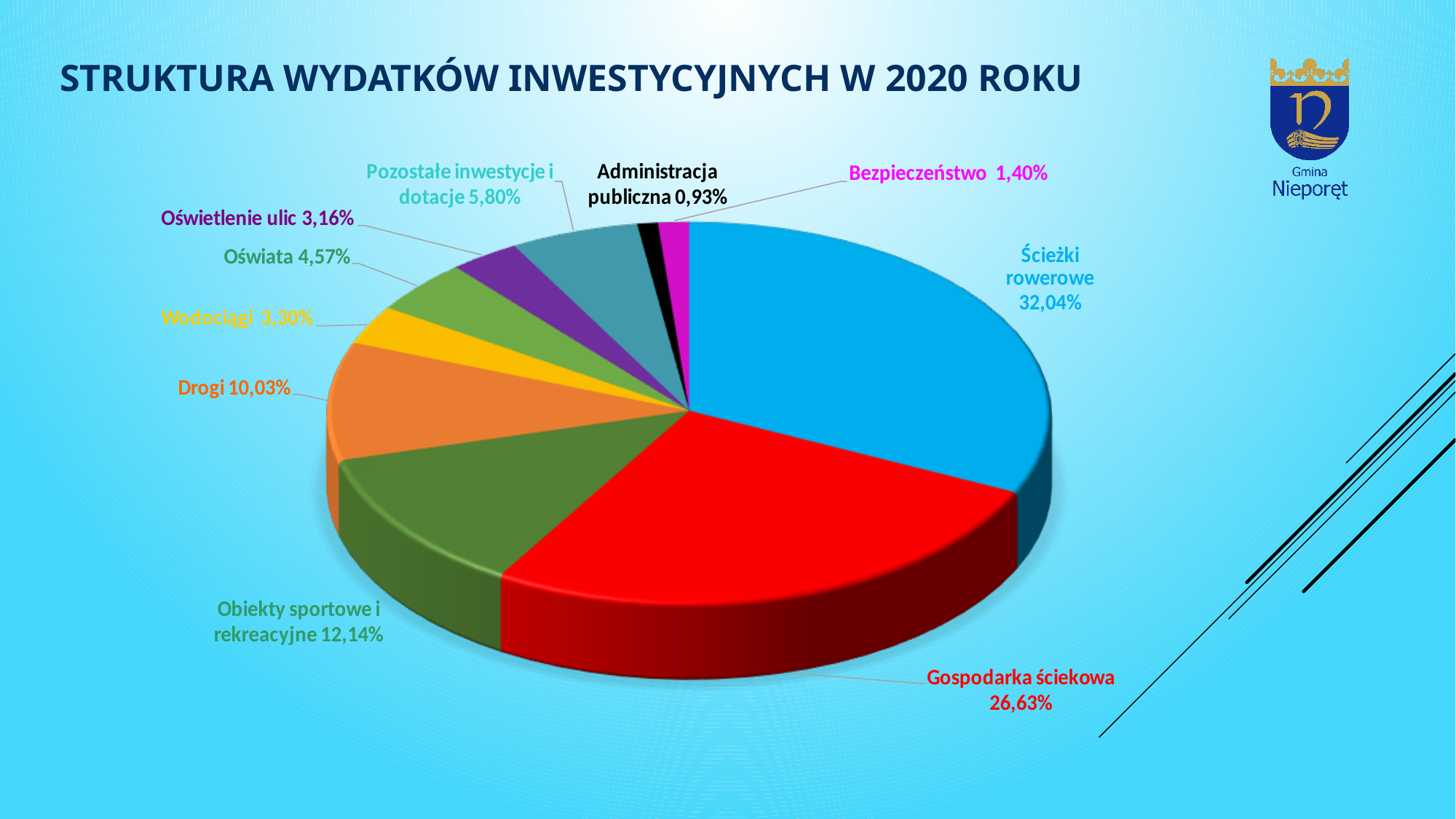
How many categories (slices) does the pie chart have? 10 What is the share for Ścieżki rowerowe? 32,04% What type of chart is shown on the slide? pie chart Which is larger, the share for Oświata or the share for Wodociągi? Oświata What is the difference between the shares for Obiekty sportowe i rekreacyjne and Drogi? 2,11% What is the share for Gospodarka ściekowa? 26,63% What is the share for Drogi? 10,03% Which category has the largest share of the pie? Ścieżki rowerowe What is the share for Administracja publiczna? 0,93% What is the title of the slide containing the chart? STRUKTURA WYDATKÓW INWESTYCYJNYCH W 2020 ROKU What is the difference between the shares for Ścieżki rowerowe and Gospodarka ściekowa? 5,41% Which category has the smallest share of the pie? Administracja publiczna